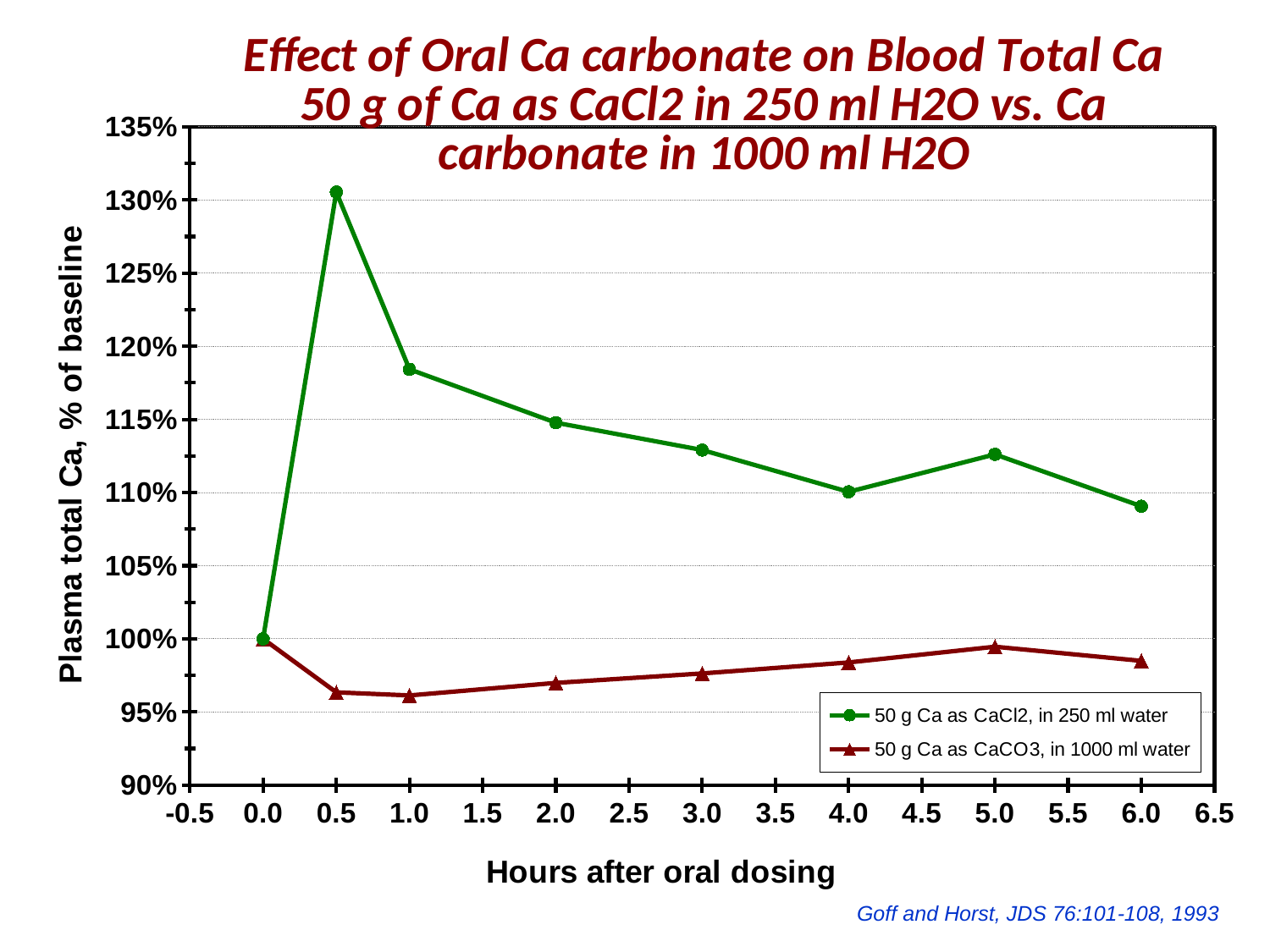
At 2.0 hours after oral dosing, which series has the higher plasma total Ca: CaCl2 in 250 ml water or CaCO3 in 1000 ml water? 50 g Ca as CaCl2, in 250 ml water Is the value for '50 g Ca as CaCO3, in 1000 ml water' at 0.5 hours greater or less than 100%? less How many data points are plotted for the '50 g Ca as CaCl2, in 250 ml water' series? 8 Which series is drawn with triangle markers? 50 g Ca as CaCO3, in 1000 ml water Is the value for '50 g Ca as CaCl2, in 250 ml water' at 0.5 hours greater or less than 125%? greater What is the title of the x axis? Hours after oral dosing What kind of chart is shown on the slide? line chart How many series does the legend list? 2 Between 1.0 and 4.0 hours after oral dosing, does the '50 g Ca as CaCl2, in 250 ml water' series rise or fall? fall At how many hours after oral dosing does the '50 g Ca as CaCl2, in 250 ml water' series reach its highest value? 0.5 What is the value of the '50 g Ca as CaCl2, in 250 ml water' series at 0.0 hours after oral dosing? 100% Is the value for '50 g Ca as CaCl2, in 250 ml water' at 1.0 hours greater or less than 115%? greater